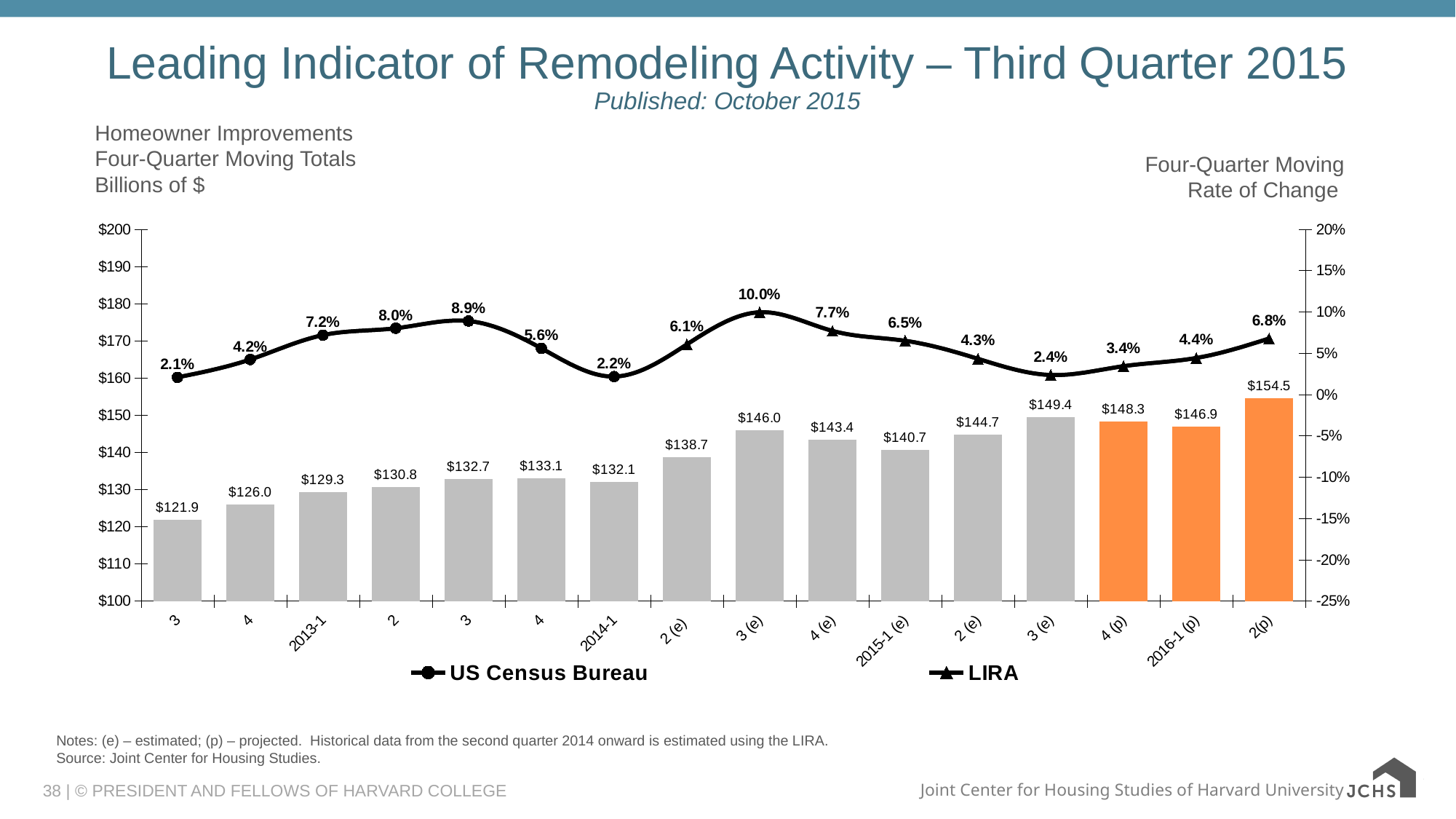
Which has the larger four-quarter moving total, 2015-1 (e) or 2014-1? 2015-1 (e) What is the lowest four-quarter moving rate of change shown on the line? 2.1% What colour are the bars for the projected (p) periods? Orange What kind of chart is shown on the slide? Combination bar and line chart What is the four-quarter moving total for 2013-1? $129.3 How many series does the legend list? 2 What is the four-quarter moving total for 2016-1 (p)? $146.9 Which period has the highest four-quarter moving total? 2(p) What is the difference between the four-quarter moving totals for 2(p) and 3 (e) in 2015? $5.1 Does the rate of change line rise or fall from 3 (e) in 2014 to 3 (e) in 2015? Fall How many bars are plotted in the chart? 16